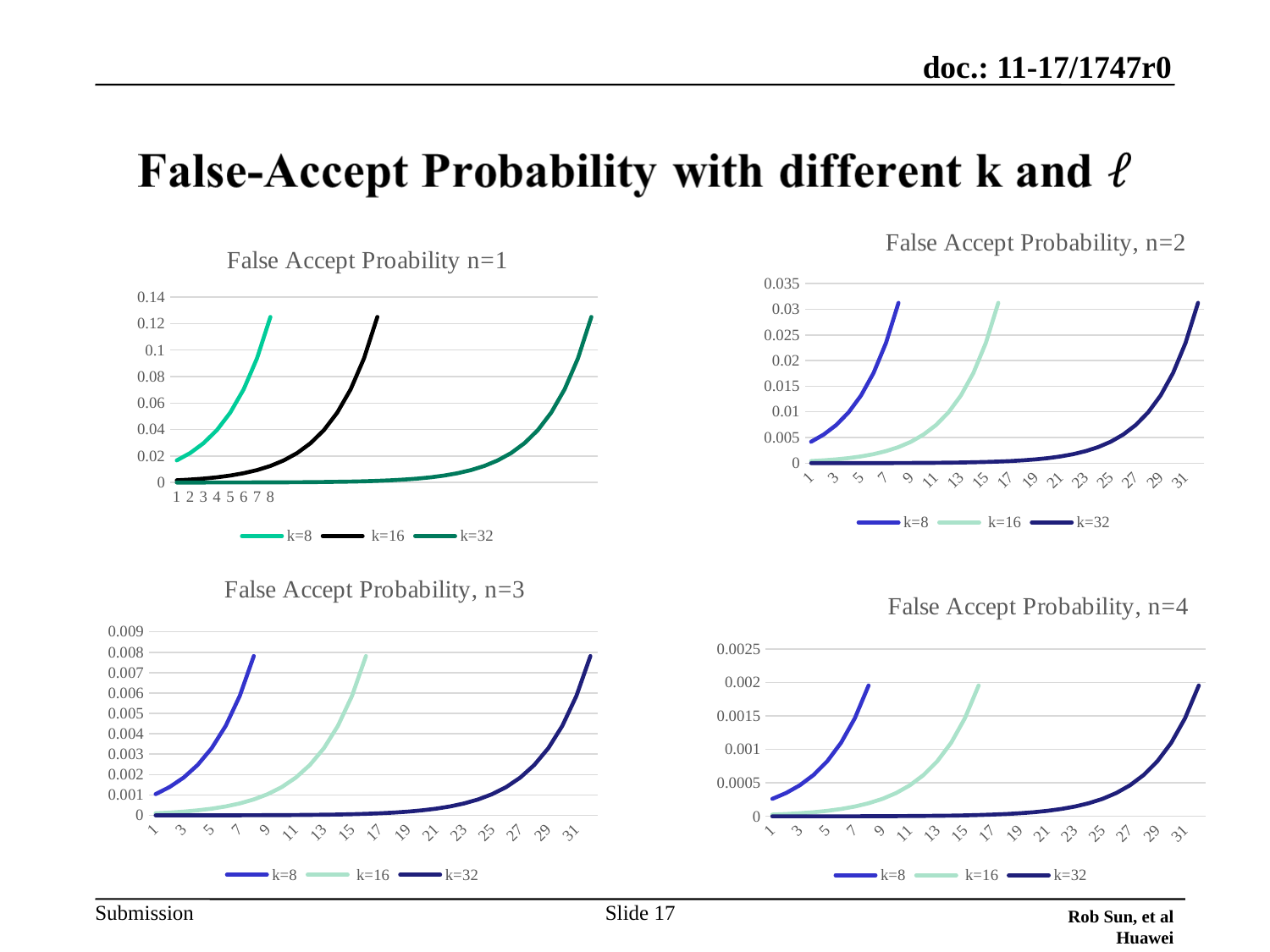
In the 'False Accept Probability, n=3' chart, is the value of the k=32 series at x=1 greater or less than 0.001? less In the 'False Accept Proability n=1' chart, which series is drawn in black? k=16 In the 'False Accept Proability n=1' chart, is the value of the k=8 series at x=8 greater or less than 0.1? greater What kind of chart is the 'False Accept Proability n=1' chart? line chart In the 'False Accept Probability, n=4' chart, is the value of the k=16 series at x=16 greater or less than 0.0015? greater In the 'False Accept Probability, n=3' chart, do the values of the k=32 series rise or fall as x increases? rise How many charts are shown on the slide? 4 In the 'False Accept Proability n=1' chart, at x=8, which series has the larger value, k=8 or k=32? k=8 What are the legend entries of the 'False Accept Probability, n=4' chart? k=8, k=16, k=32 How many series does the legend of the 'False Accept Probability, n=2' chart list? 3